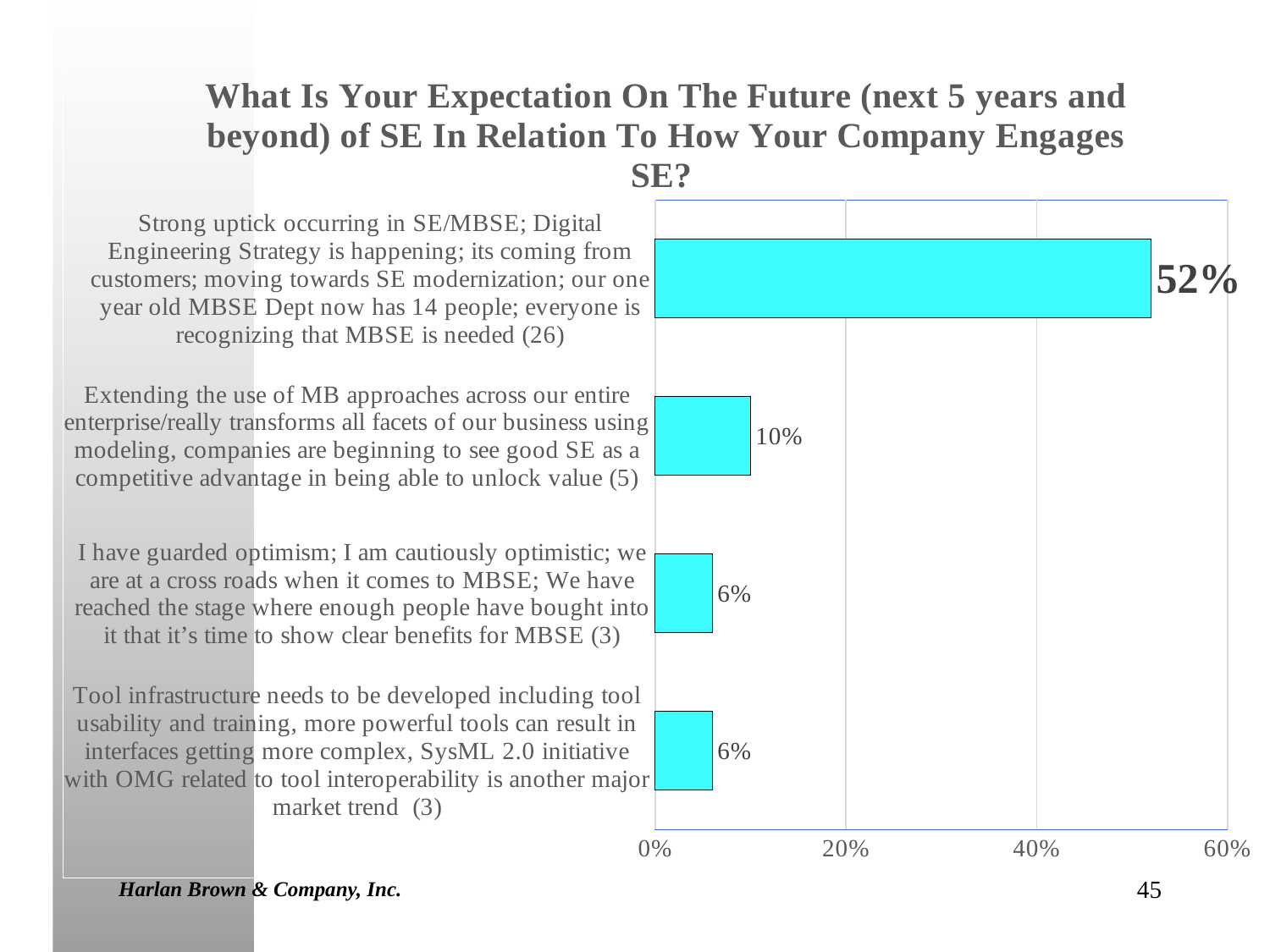
What is the difference between the value for 'Extending the use of MB approaches...' and the value for 'I have guarded optimism...'? 4% What is the difference between the value for 'Strong uptick occurring in SE/MBSE...' and the value for 'Extending the use of MB approaches...'? 42% What kind of chart is shown on the slide? bar chart What is the value for the category 'Tool infrastructure needs to be developed including tool usability and training...' (3)? 6% How many categories are shown in the chart? 4 What is the maximum value shown on the horizontal axis? 60% What is the value for the category 'I have guarded optimism; I am cautiously optimistic...' (3)? 6% Is the value for 'Strong uptick occurring in SE/MBSE...' greater or less than 40%? greater Which is larger: the value for 'Extending the use of MB approaches...' or the value for 'Tool infrastructure needs to be developed...'? Extending the use of MB approaches... What is the value for the category 'Strong uptick occurring in SE/MBSE; Digital Engineering Strategy is happening...' (26)? 52% What is the value for the category 'Extending the use of MB approaches across our entire enterprise...' (5)? 10%